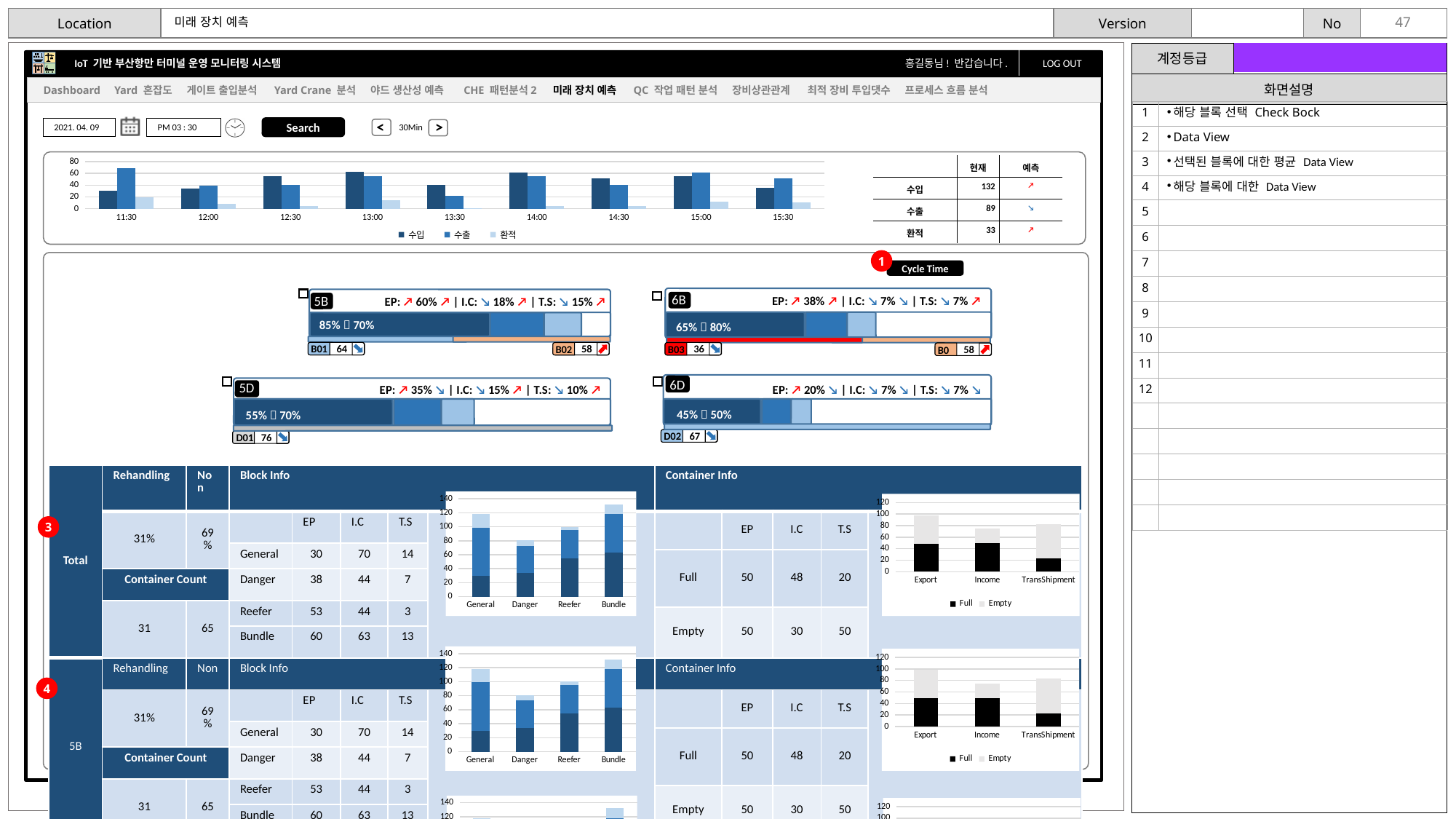
In the bar chart at the top of the slide, how many series does the legend list? 3 In the bar chart at the top of the slide, what are the three legend entries? 수입, 수출, 환적 In the Container Info chart in the Total section, what are the two legend entries? Full, Empty In the Block Info chart in the Total section, is the total stacked value for Bundle greater or less than 120? greater In the Container Info chart in the Total section, which category has the tallest stacked bar? Export In the Block Info chart in the Total section, which category has the tallest stacked bar? Bundle In the bar chart at the top of the slide, how many time points are shown on the x axis? 9 In the Block Info chart in the Total section, how many categories are on the x axis? 4 What kind of chart is the Block Info chart in the Total section? stacked bar chart In the Block Info chart in the Total section, which category has the shortest stacked bar? Danger In the bar chart at the top of the slide, is the 수입 value at 11:30 greater or less than 60? less